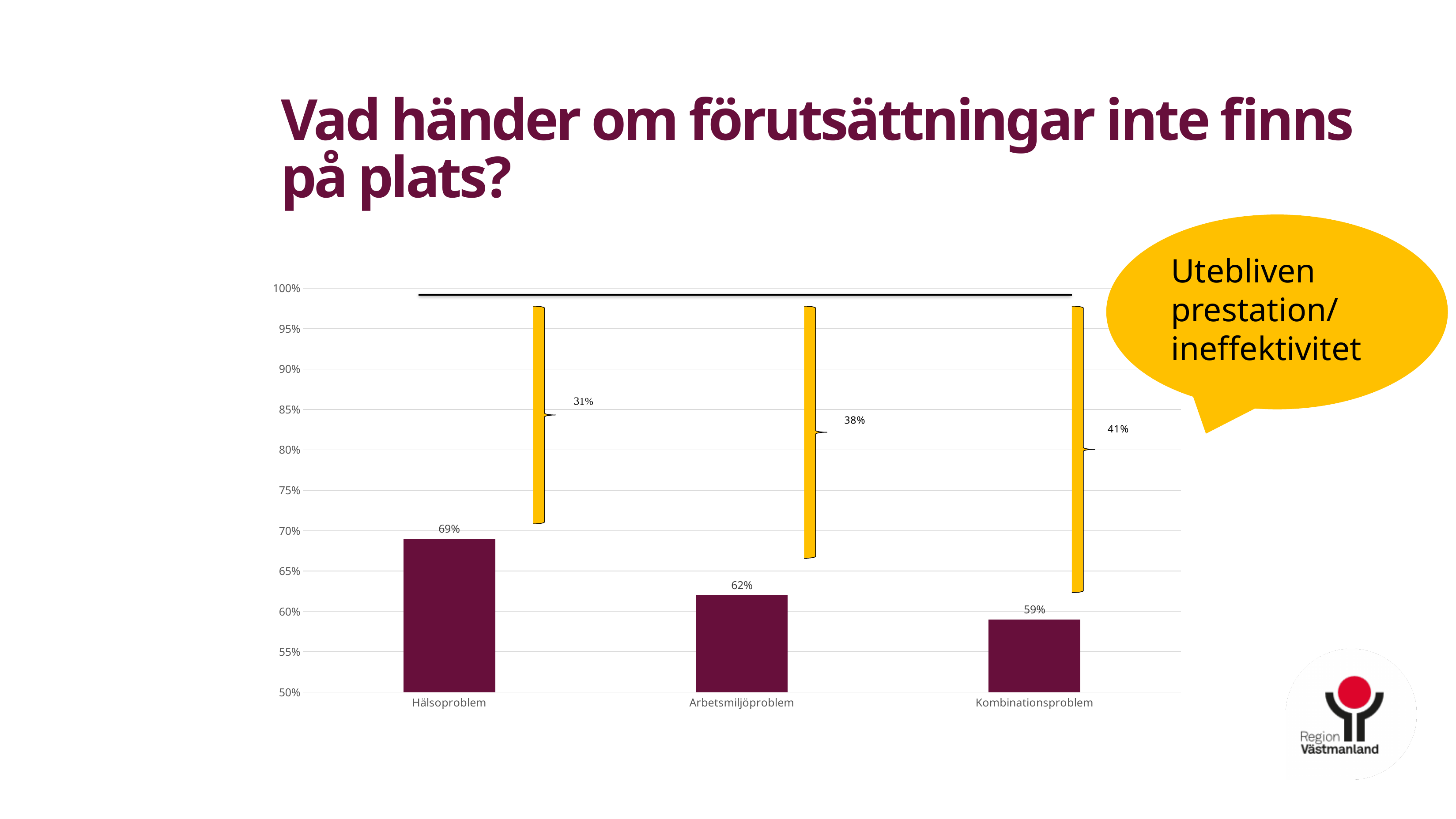
What is the value for Hälsoproblem? 69% What kind of chart is shown on the slide? bar chart Which is larger, the value for Arbetsmiljöproblem or the value for Kombinationsproblem? Arbetsmiljöproblem What is the difference between the values for Hälsoproblem and Kombinationsproblem? 10% Which category has the lowest bar? Kombinationsproblem What is the value for Kombinationsproblem? 59% How many categories are shown on the x axis? 3 Do the bar values rise or fall from left to right along the x axis? fall What is the difference between the values for Hälsoproblem and Arbetsmiljöproblem? 7% Is the value for Arbetsmiljöproblem greater or less than 65%? less Which category has the highest bar? Hälsoproblem What is the value for Arbetsmiljöproblem? 62%